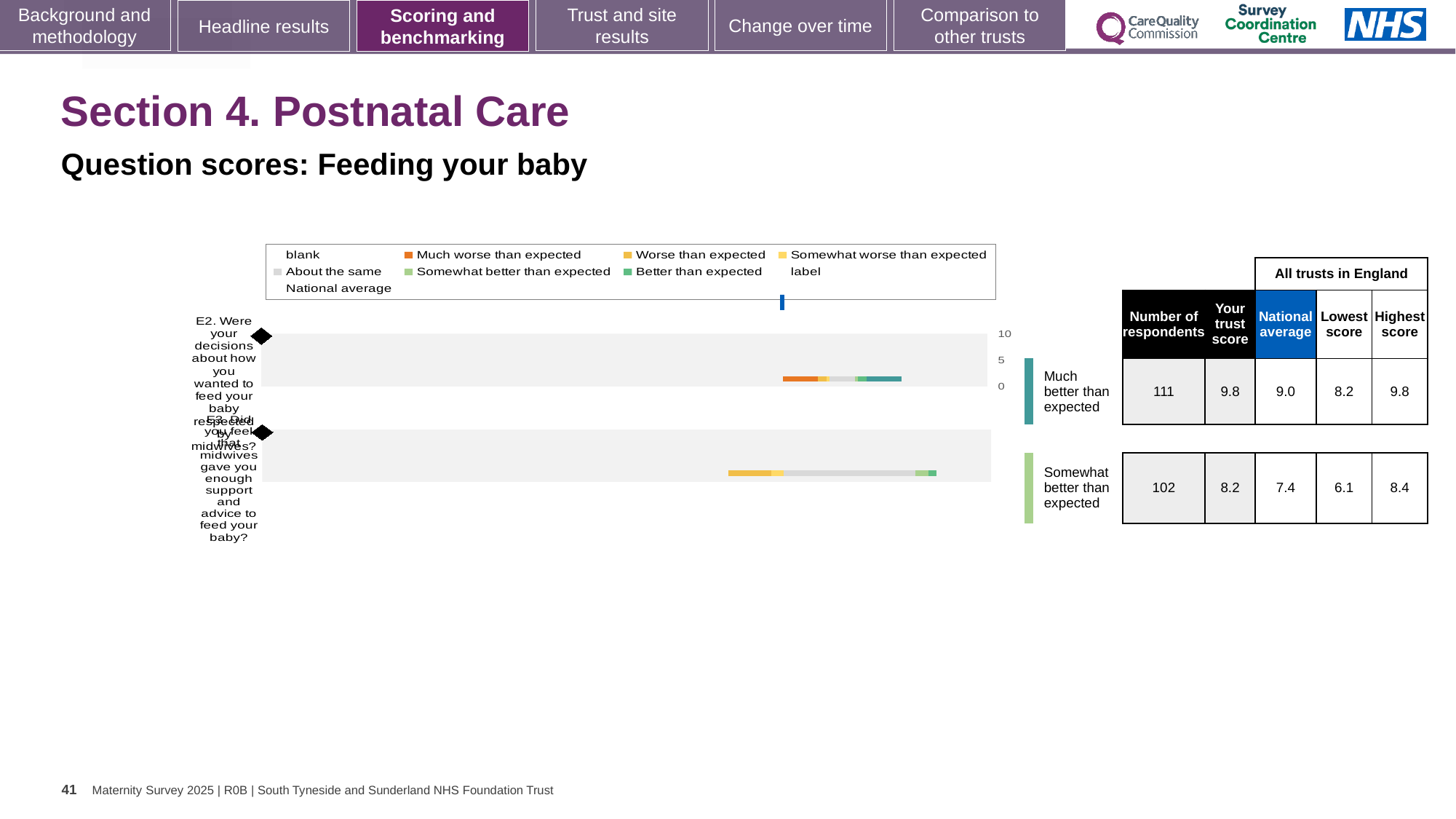
What is the lowest score across all trusts in England for question E3? 6.1 How many questions (categories) are plotted in the chart? 2 Which benchmark category is shown for question E3? Somewhat better than expected What is the national average score for question E3 (midwives gave you enough support and advice to feed your baby)? 7.4 Which question has the higher trust score, E2 or E3? E2 Which benchmark category is shown for question E2? Much better than expected How many more respondents answered question E2 than question E3? 9 What is the difference between the trust score and the national average for question E3? 0.8 What kind of chart is shown on the slide? bar chart What is the trust score for question E2 (decisions about how you wanted to feed your baby respected by midwives)? 9.8 How many respondents answered question E2? 111 What is the highest score across all trusts in England for question E2? 9.8